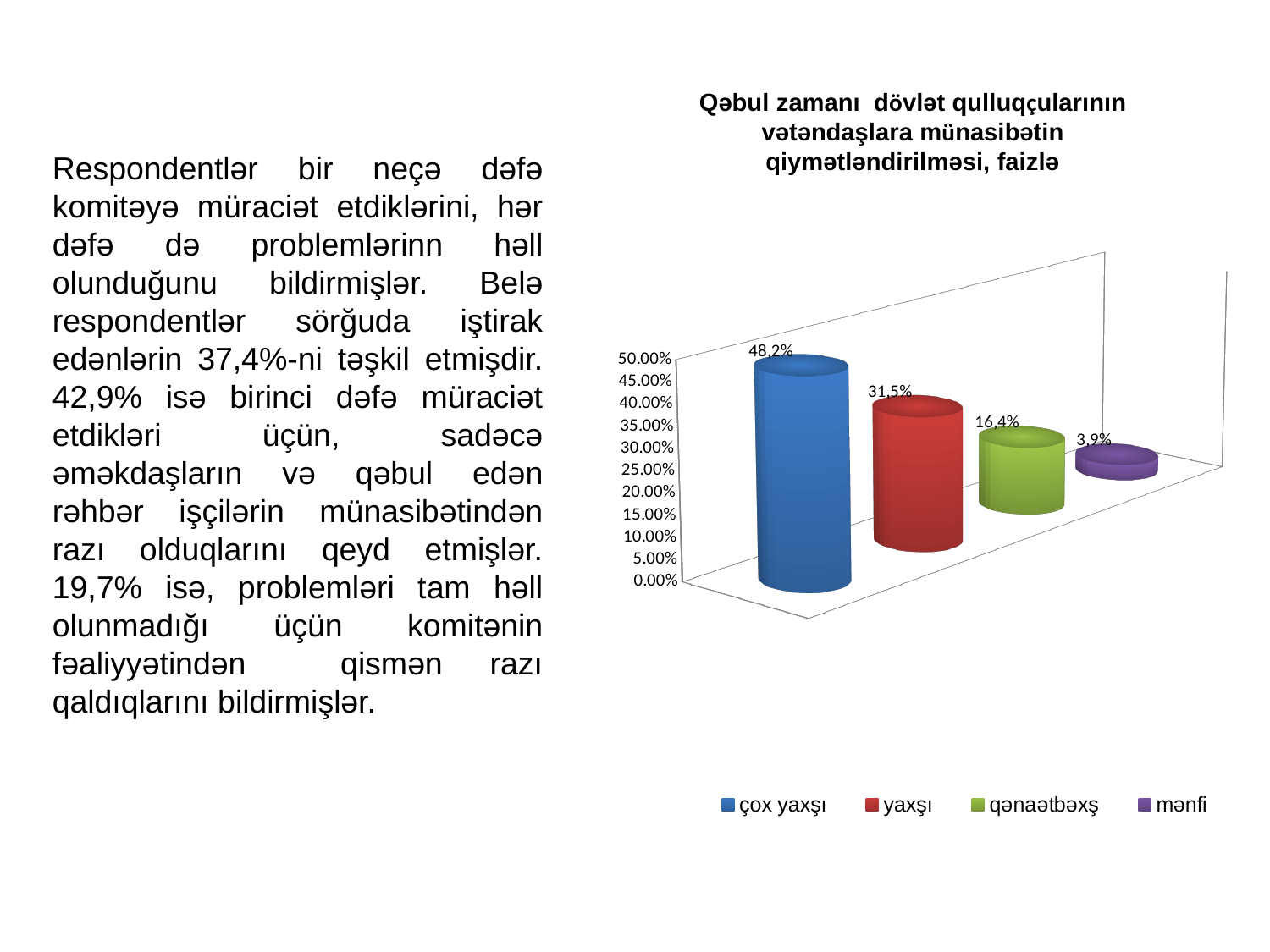
What is the value for "qənaətbəxş"? 16,4% Which category has the lowest value? mənfi What is the difference between the values for "çox yaxşı" and "yaxşı"? 16,7% What kind of chart is shown on the slide? Bar chart What is the value for "çox yaxşı"? 48,2% How many categories are shown in the chart? 4 What is the value for "mənfi"? 3,9% What is the value for "yaxşı"? 31,5% What is the difference between the values for "qənaətbəxş" and "mənfi"? 12,5% Which category has the highest value? çox yaxşı Do the values rise or fall from left to right across the categories? Fall Which is larger, the value for "yaxşı" or the value for "qənaətbəxş"? yaxşı